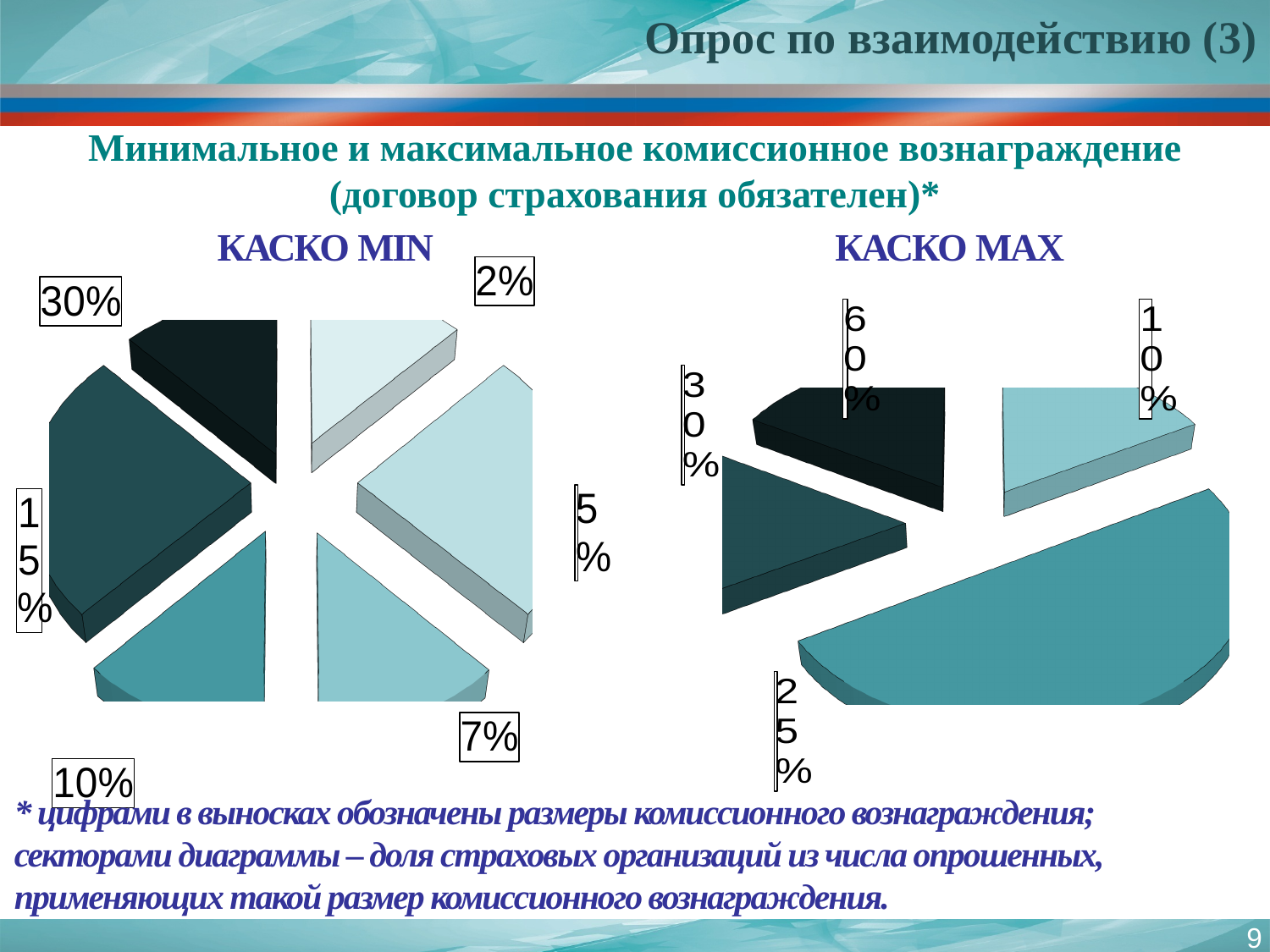
What is the title of the chart on the left side of the slide? КАСКО MIN In the КАСКО MIN chart, which labeled commission size corresponds to the largest slice? 15% and 5% (the two slices are equal in size) In the КАСКО MAX chart, what is the highest commission size labeled? 60% In the КАСКО MAX chart, which labeled commission size corresponds to the largest slice? 25% In the КАСКО MIN chart, what is the lowest commission size labeled? 2% According to the footnote, what do the numbers in the callouts represent? Sizes of commission remuneration In the КАСКО MIN chart, what commission sizes are shown in the callouts? 30%, 2%, 5%, 7%, 10%, 15% In the КАСКО MAX chart, how many slices (sectors) are there? 4 In the КАСКО MAX chart, what commission sizes are shown in the callouts? 60%, 10%, 30%, 25% In the КАСКО MIN chart, how many slices (sectors) are there? 6 What kind of chart is used for КАСКО MIN and КАСКО MAX? Pie chart Which commission sizes appear as labels in both the КАСКО MIN and КАСКО MAX charts? 10% and 30%